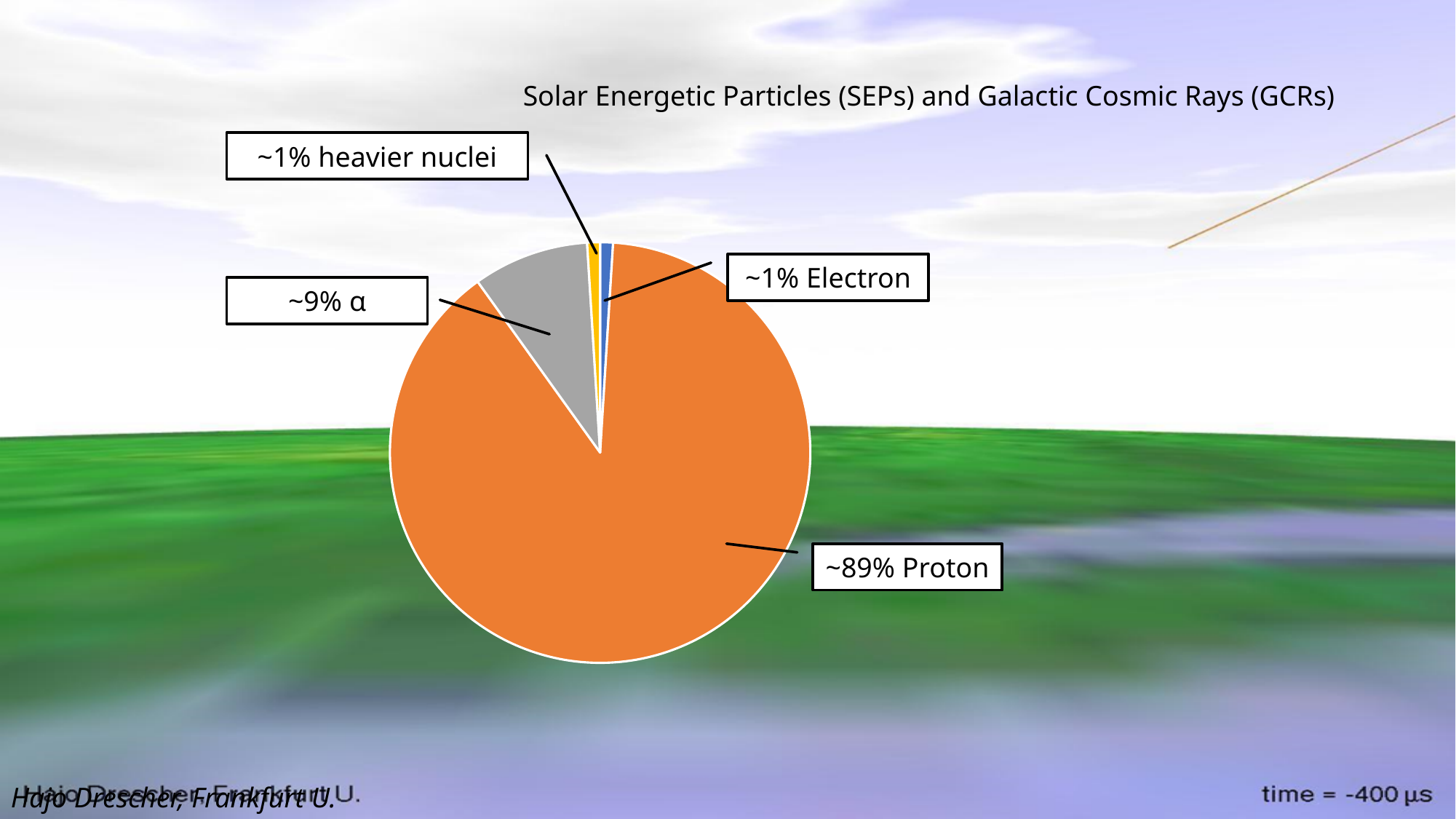
What share of the pie is labelled for Proton? ~89% Which slice is larger, Proton or α? Proton How many slices does the pie chart have? 4 Which slice of the pie chart is the largest? Proton Which slice is larger, α or Electron? α What colour is the Proton slice? orange What is the title of the chart? Solar Energetic Particles (SEPs) and Galactic Cosmic Rays (GCRs) What share of the pie is labelled for Electron? ~1% What kind of chart is shown on the slide? pie chart What share of the pie is labelled for heavier nuclei? ~1% What share of the pie is labelled for α? ~9%